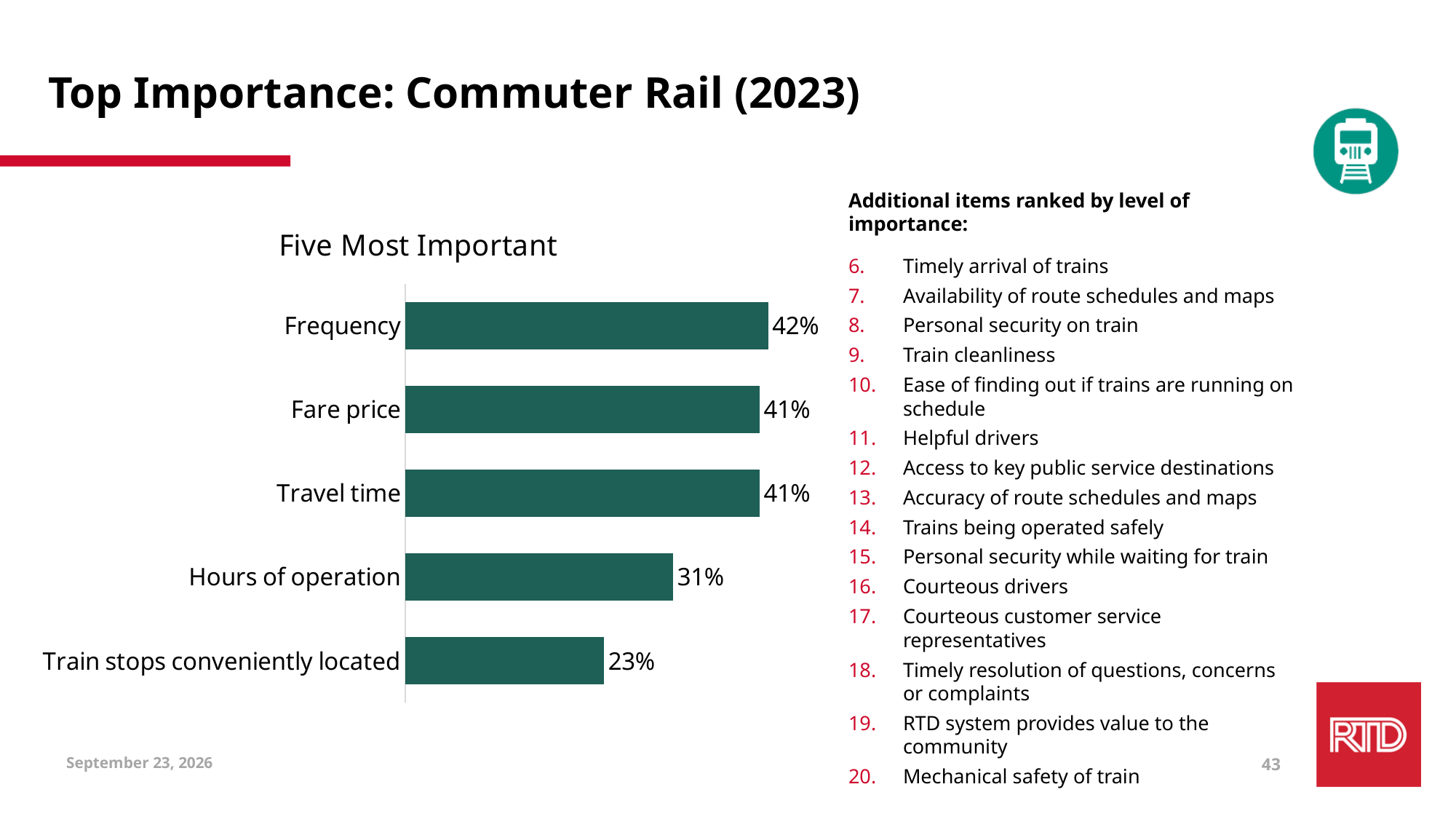
What is the value for Frequency? 42% Which category has the highest value? Frequency Which is larger, the value for Hours of operation or the value for Train stops conveniently located? Hours of operation What kind of chart is shown on the slide? bar chart What is the value for Fare price? 41% What is the difference between the values for Travel time and Hours of operation? 10% What is the value for Hours of operation? 31% What is the difference between the values for Frequency and Train stops conveniently located? 19% What is the title of the chart? Five Most Important How many categories are shown in the chart? 5 What is the value for Train stops conveniently located? 23% Which category has the lowest value? Train stops conveniently located